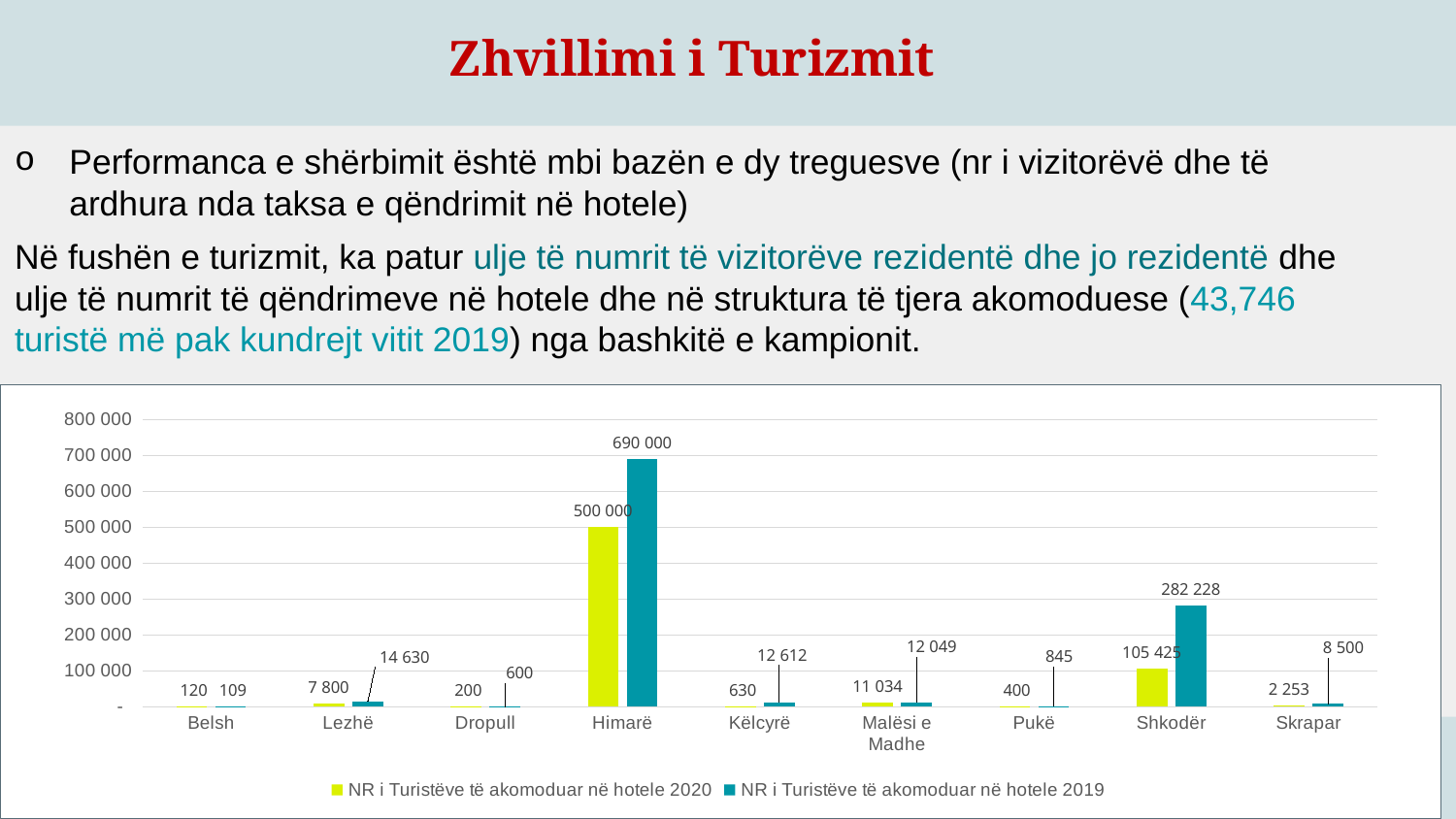
How many series does the chart legend list? 2 What kind of chart is shown on the slide? bar chart What is the value for Shkodër in the series 'NR i Turistëve të akomoduar në hotele 2020'? 105 425 For Belsh, which is larger: the 2020 value or the 2019 value? the 2020 value What is the value for Këlcyrë in the series 'NR i Turistëve të akomoduar në hotele 2019'? 12 612 What is the difference between the 2019 and 2020 values for Shkodër? 176 803 How many municipalities (categories) are shown on the x axis of the chart? 9 Which colour represents the series 'NR i Turistëve të akomoduar në hotele 2020' in the chart? yellow-green What is the difference between the 2019 and 2020 values for Himarë? 190 000 What is the value for Himarë in the series 'NR i Turistëve të akomoduar në hotele 2019'? 690 000 Which municipality has the highest value in the series 'NR i Turistëve të akomoduar në hotele 2019'? Himarë Which municipality has the lowest value in the series 'NR i Turistëve të akomoduar në hotele 2020'? Belsh